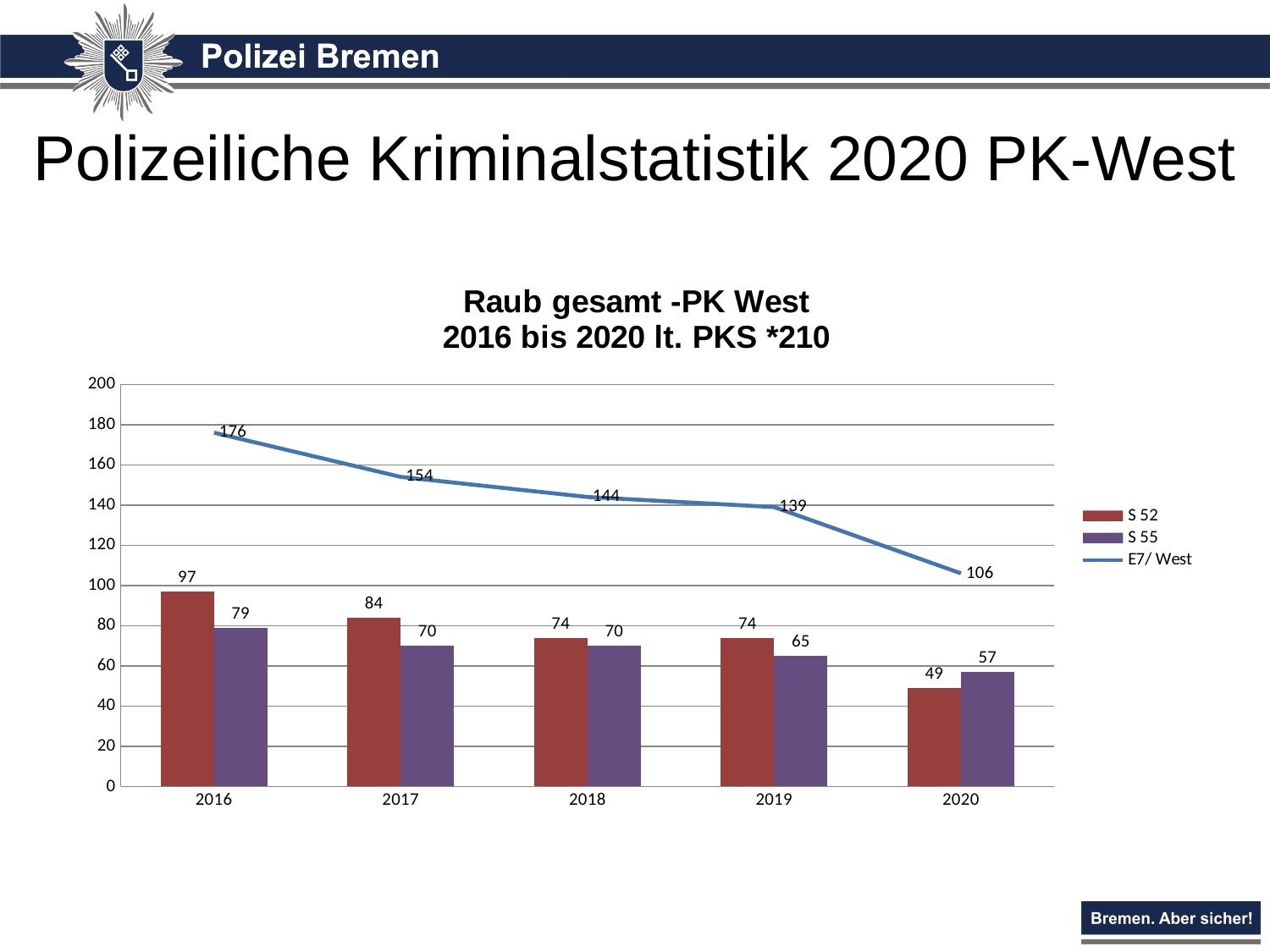
Is the value for E7/ West in 2017 greater or less than 140? greater What is the value for S 55 in 2019? 65 What is the value for E7/ West in 2020? 106 How many series does the legend list? 3 How many years are shown on the x axis? 5 In which year is the S 52 value lowest? 2020 What is the title of the chart? Raub gesamt -PK West 2016 bis 2020 lt. PKS *210 Does the E7/ West line rise or fall from 2016 to 2020? fall In which year is the E7/ West line highest? 2016 Which is larger in 2020, S 52 or S 55? S 55 What is the difference between the E7/ West values for 2016 and 2020? 70 What is the value for S 52 in 2016? 97